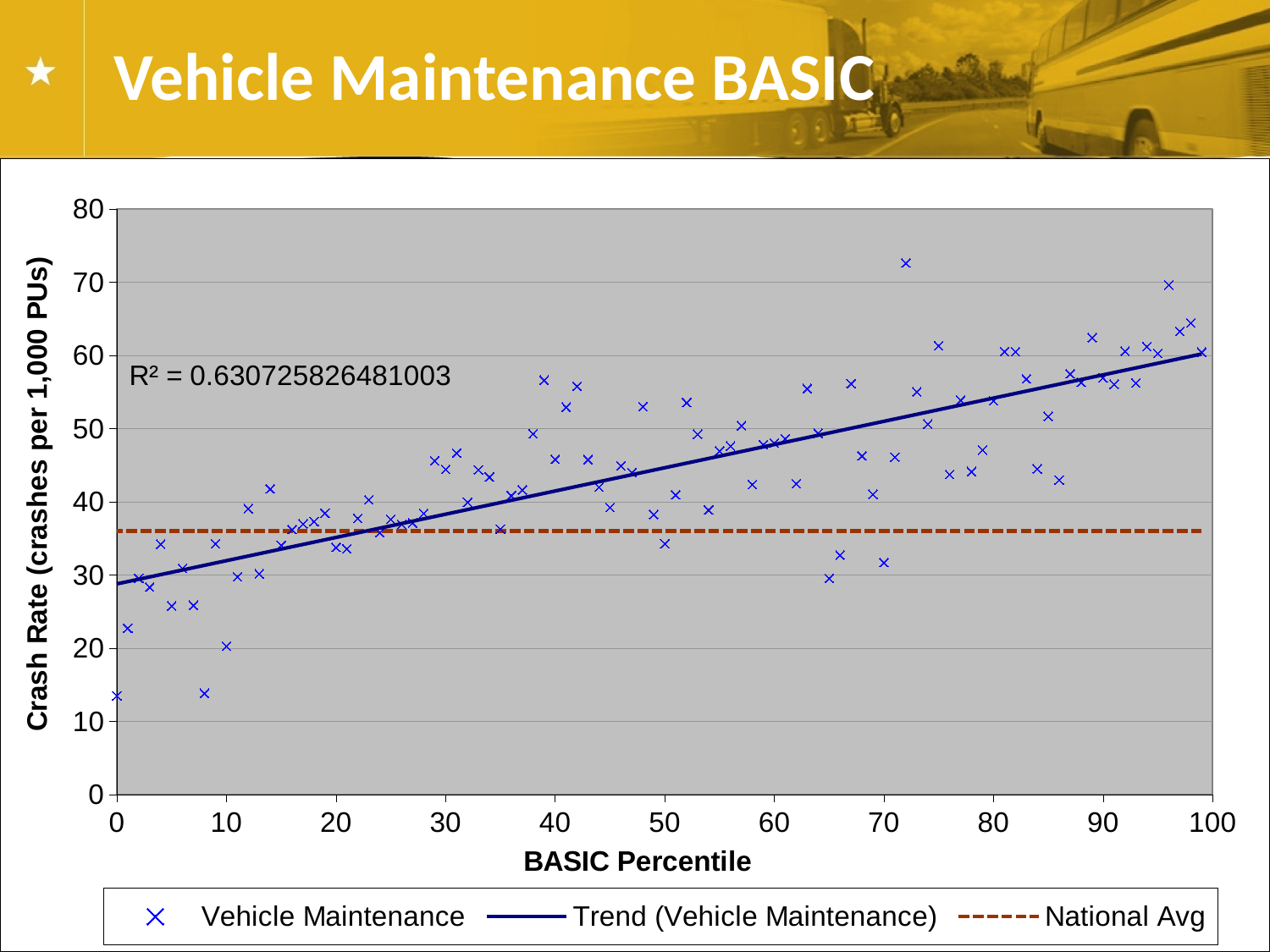
Is the National Avg line greater or less than 30 crashes per 1,000 PUs? greater What kind of chart is shown on the slide? Scatter chart Is the Vehicle Maintenance data point at BASIC Percentile 0 greater or less than 20 crashes per 1,000 PUs? less What is the title of the y axis? Crash Rate (crashes per 1,000 PUs) Does the trend line for Vehicle Maintenance rise or fall as the BASIC Percentile increases? Rises Is the National Avg line greater or less than 40 crashes per 1,000 PUs? less What is the title of the x axis? BASIC Percentile What R² value is printed on the chart? R² = 0.630725826481003 Which legend entry is drawn as a dashed line? National Avg How many series does the legend list? 3